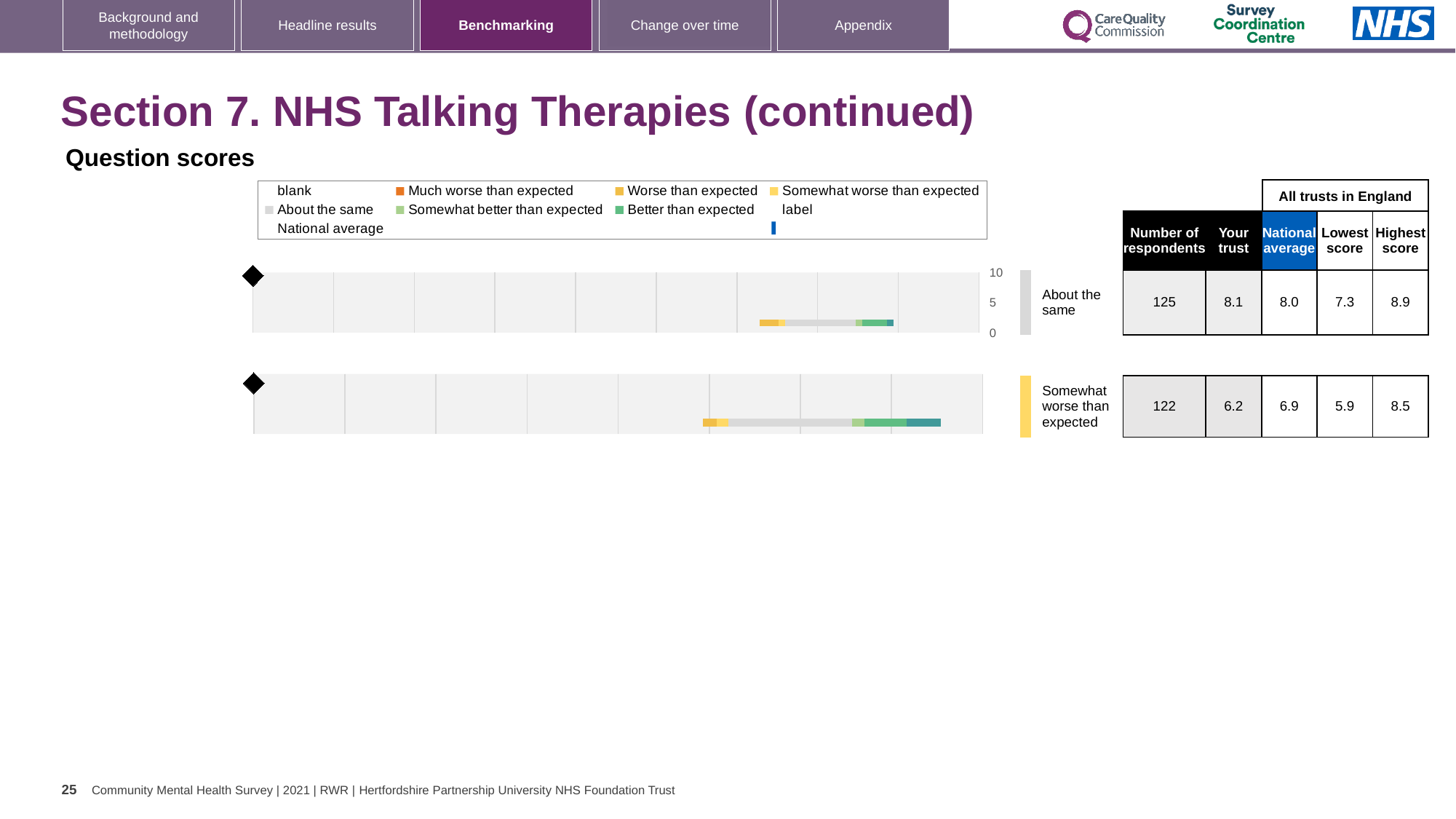
How many charts are shown on the slide? 2 For the bottom chart (benchmarked 'Somewhat worse than expected'), how many respondents are there? 122 What kind of chart is used for the top chart on the slide? bar chart What is the highest value shown on the vertical axis of the top chart? 10 For the bottom chart (benchmarked 'Somewhat worse than expected'), what is the 'Your trust' score? 6.2 For the top chart, what is the difference between the highest score and the lowest score across all trusts in England? 1.6 For the bottom chart, what is the difference between the national average and the 'Your trust' score? 0.7 For the top chart (benchmarked 'About the same'), what is the national average score? 8.0 For the bottom chart, which is larger: the 'Your trust' score or the national average? National average For the top chart, which is larger: the 'Your trust' score or the national average? Your trust What benchmark category is shown next to the bottom chart? Somewhat worse than expected For the top chart (benchmarked 'About the same'), what is the 'Your trust' score? 8.1